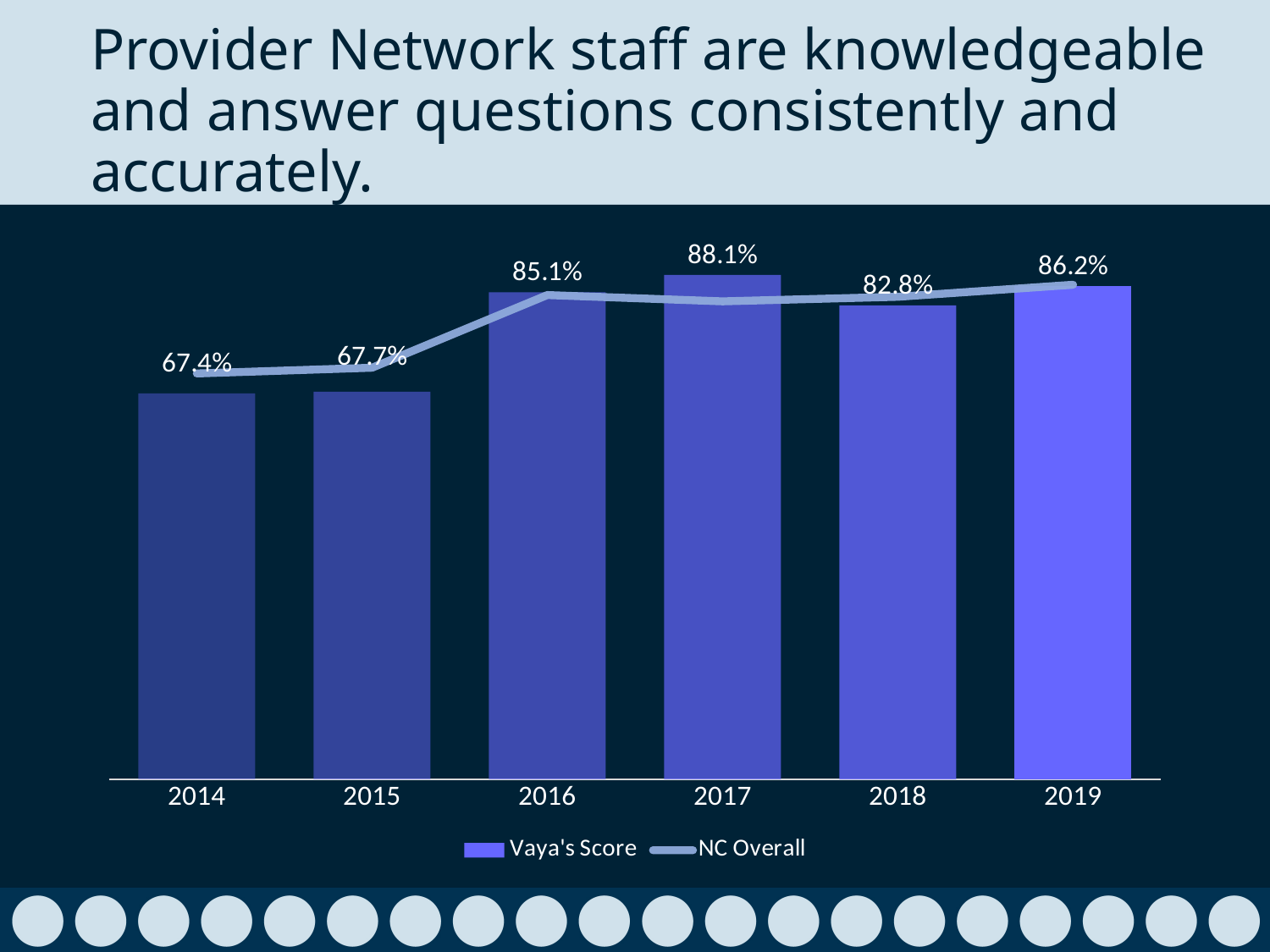
What is the difference between Vaya's Score in 2016 and in 2015? 17.4% What kind of chart is used to show Vaya's Score? Bar chart Which year has the highest Vaya's Score? 2017 What is Vaya's Score for 2019? 86.2% What is Vaya's Score for 2017? 88.1% Which year has a higher Vaya's Score, 2016 or 2018? 2016 What is the difference between Vaya's Score in 2017 and in 2018? 5.3% Which year has the lowest Vaya's Score? 2014 How many series does the legend list? 2 How many years are shown on the x axis? 6 Which series is drawn as a line? NC Overall What is Vaya's Score for 2014? 67.4%